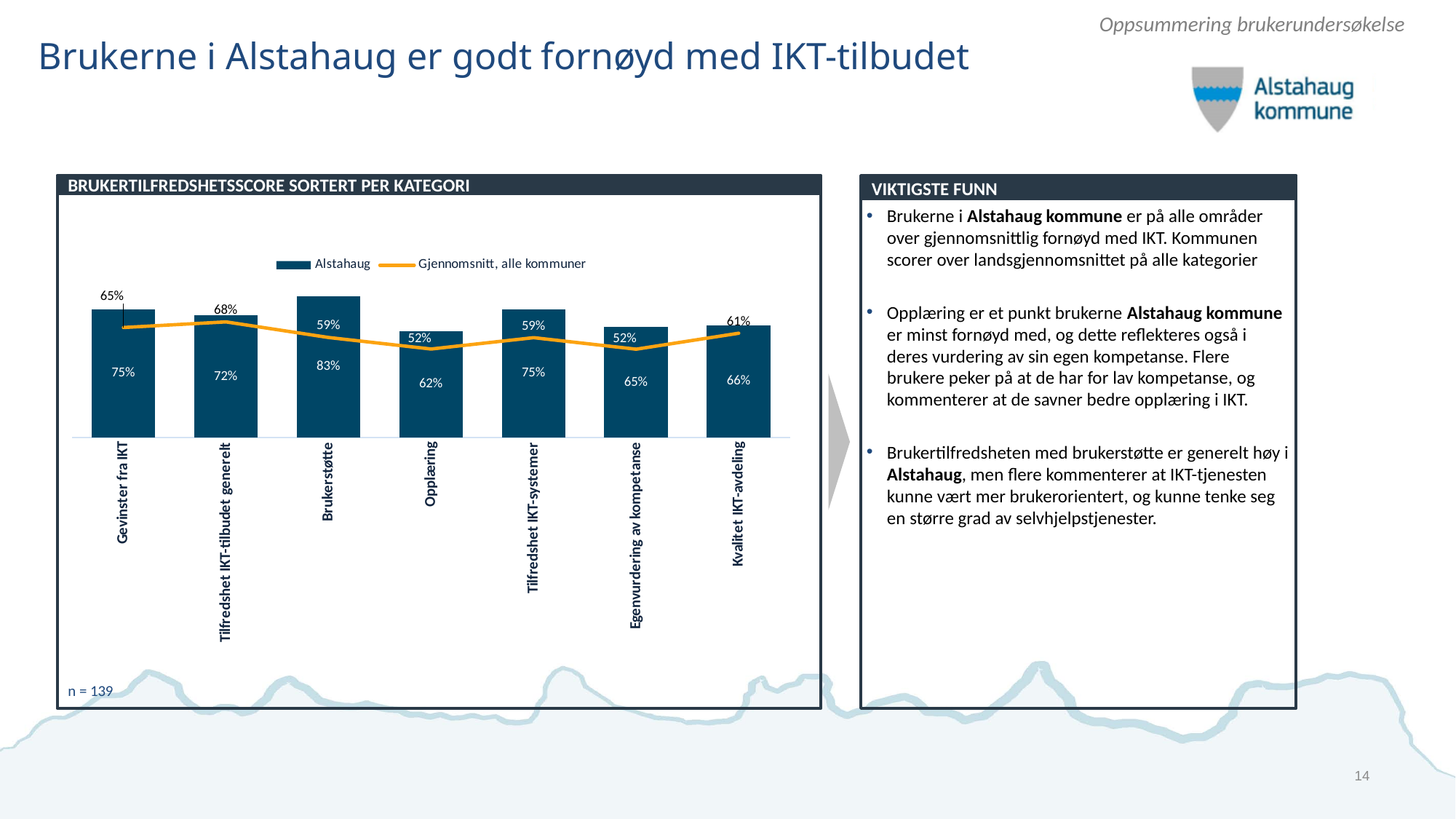
Which category has the highest Alstahaug value? Brukerstøtte What kind of chart is shown? Combined bar and line chart What is the Gjennomsnitt, alle kommuner value for Opplæring? 52% What is the Alstahaug value for Kvalitet IKT-avdeling? 66% What is the sample size noted on the chart? n = 139 Which is larger, the Alstahaug value for Tilfredshet IKT-tilbudet generelt or for Egenvurdering av kompetanse? Tilfredshet IKT-tilbudet generelt What is the Alstahaug value for Brukerstøtte? 83% What is the difference between the Alstahaug values for Gevinster fra IKT and Opplæring? 13% How many categories are shown on the x axis? 7 How many series does the legend list? 2 Which category has the lowest Alstahaug value? Opplæring What is the difference between the Alstahaug value and the Gjennomsnitt, alle kommuner value for Brukerstøtte? 24%